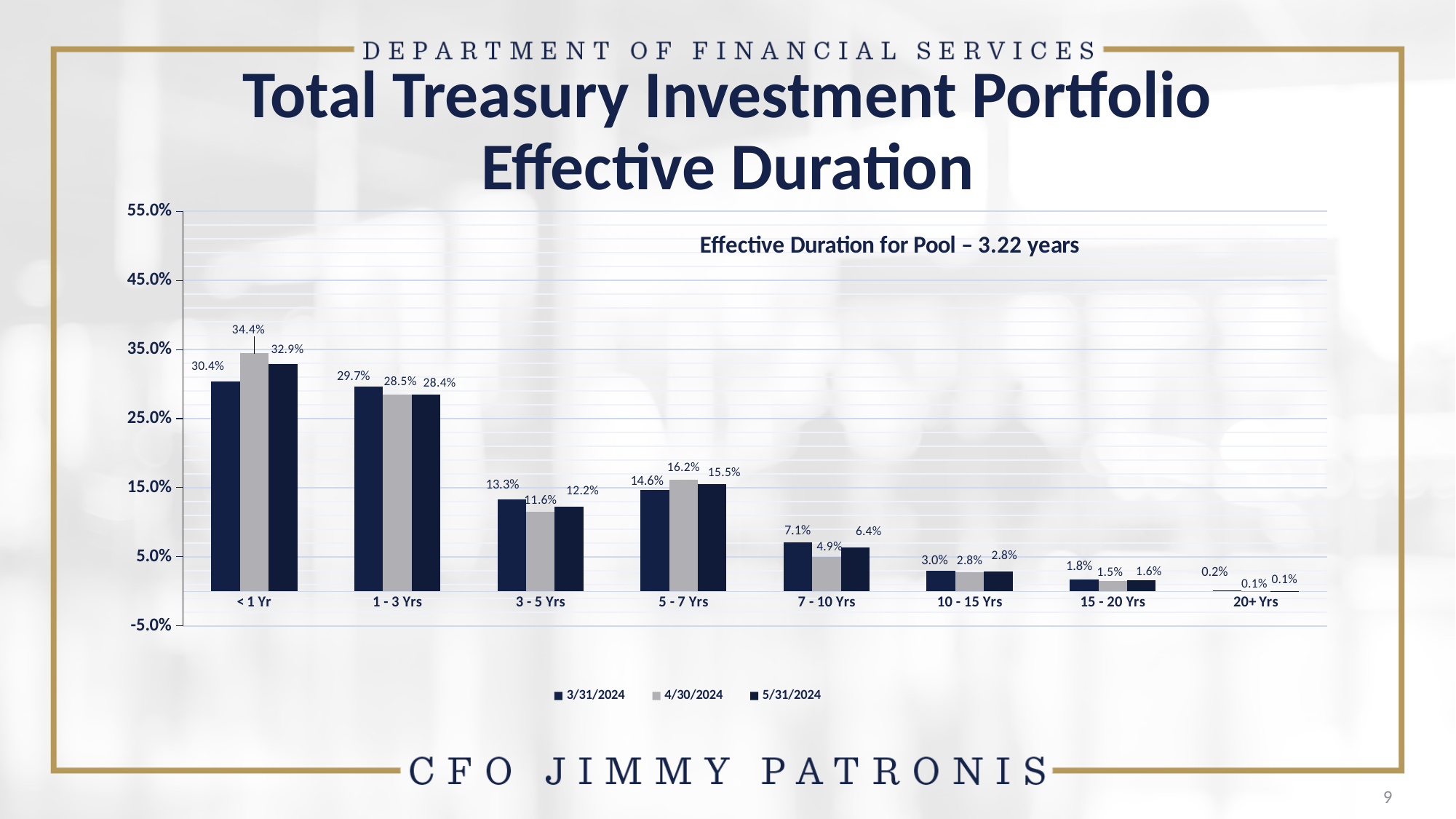
What is the value for 4/30/2024 in the < 1 Yr category? 34.4% What is the difference between the 4/30/2024 and 3/31/2024 values in the < 1 Yr category? 4.0% In the 3 - 5 Yrs category, which is larger: the 3/31/2024 value or the 4/30/2024 value? 3/31/2024 What effective duration for the pool is stated on the chart? 3.22 years How many maturity categories are shown on the x axis? 8 What is the value for 3/31/2024 in the 7 - 10 Yrs category? 7.1% Do the 5/31/2024 values rise or fall moving from < 1 Yr to 20+ Yrs along the x axis? Fall Which category has the lowest value for the 5/31/2024 series? 20+ Yrs Which category has the highest value for the 3/31/2024 series? < 1 Yr What is the value for 5/31/2024 in the 5 - 7 Yrs category? 15.5% What kind of chart is shown on the slide? Bar chart How many series does the legend list? 3